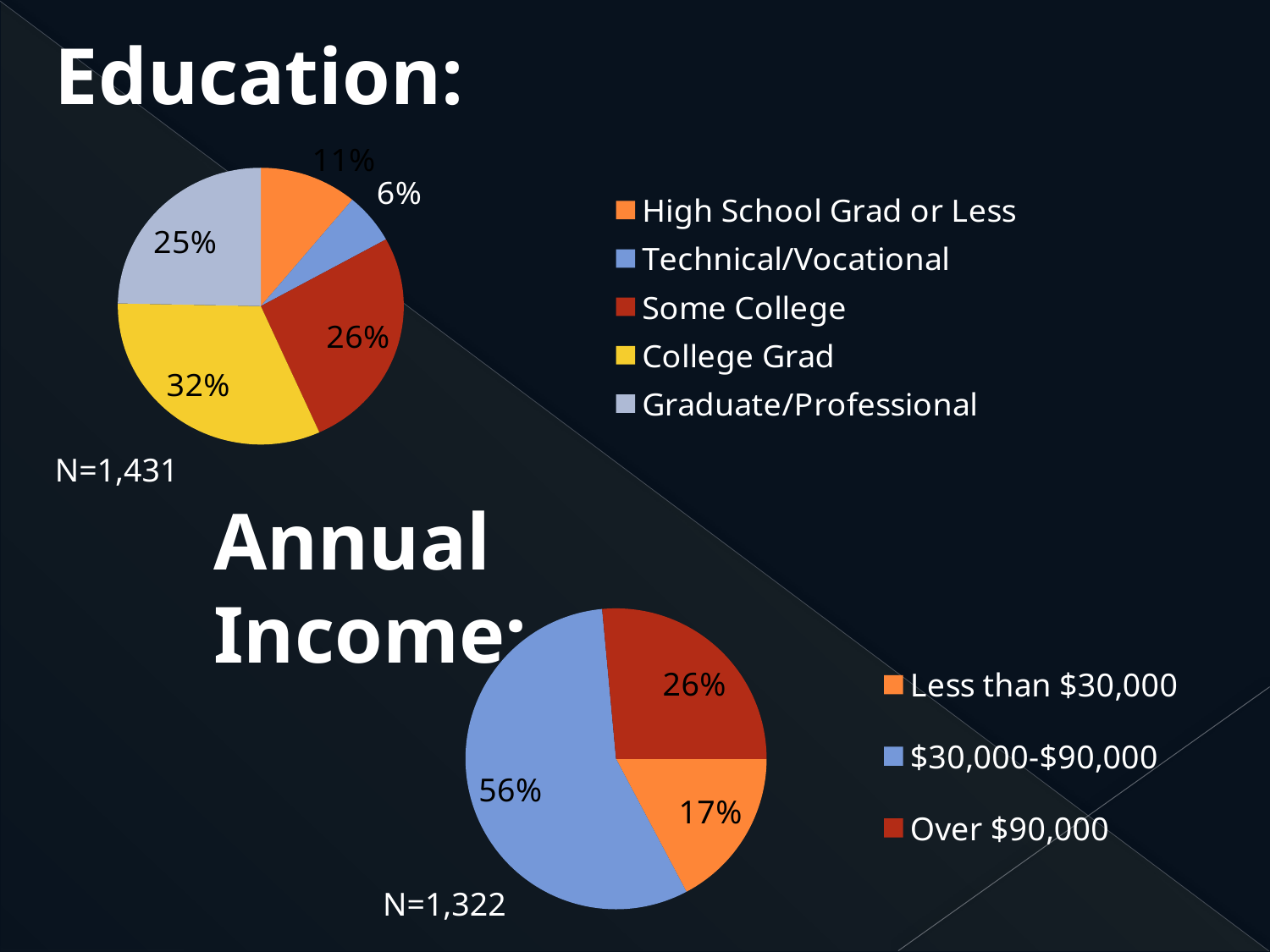
What type of chart is used for Annual Income? Pie chart In the Education pie chart, what percentage is College Grad? 32% In the Education pie chart, which category has the smallest share? Technical/Vocational In the Annual Income pie chart, what percentage is Less than $30,000? 17% In the Annual Income pie chart, what percentage is $30,000-$90,000? 56% In the Education pie chart, what is the difference between the Some College and Graduate/Professional shares? 1% In the Education pie chart, what percentage is Technical/Vocational? 6% In the Education pie chart, how many categories are shown? 5 In the Annual Income pie chart, which is larger: Over $90,000 or Less than $30,000? Over $90,000 In the Education pie chart, which category has the largest share? College Grad In the Annual Income pie chart, what is the difference between the $30,000-$90,000 and Over $90,000 shares? 30% In the Annual Income pie chart, which category has the smallest share? Less than $30,000